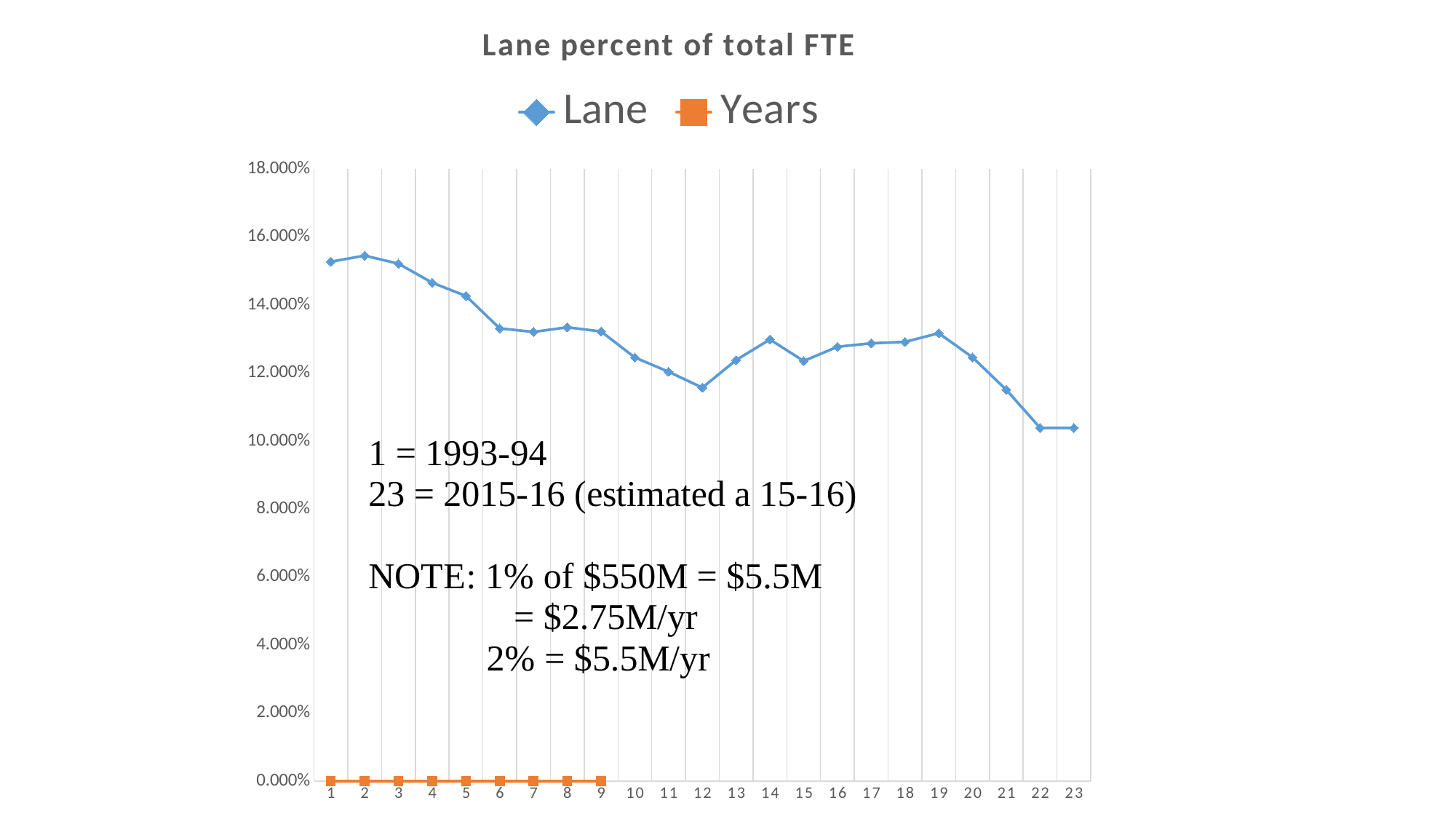
What are the two series named in the legend? Lane and Years Which has the larger Lane value, point 14 or point 12? point 14 Is the Lane value at point 23 greater or less than 10.000%? greater What is the title of the chart? Lane percent of total FTE Is the Lane value at point 1 greater or less than 14.000%? greater At which x-axis point does the Lane series reach its highest value? 2 How many series does the legend list? 2 Is the Lane value at point 12 greater or less than 12.000%? less Does the Lane series generally rise or fall from point 1 to point 23? fall How many points are plotted along the x axis for the Lane series? 23 Which has the larger Lane value, point 1 or point 23? point 1 What kind of chart is shown on the slide? line chart